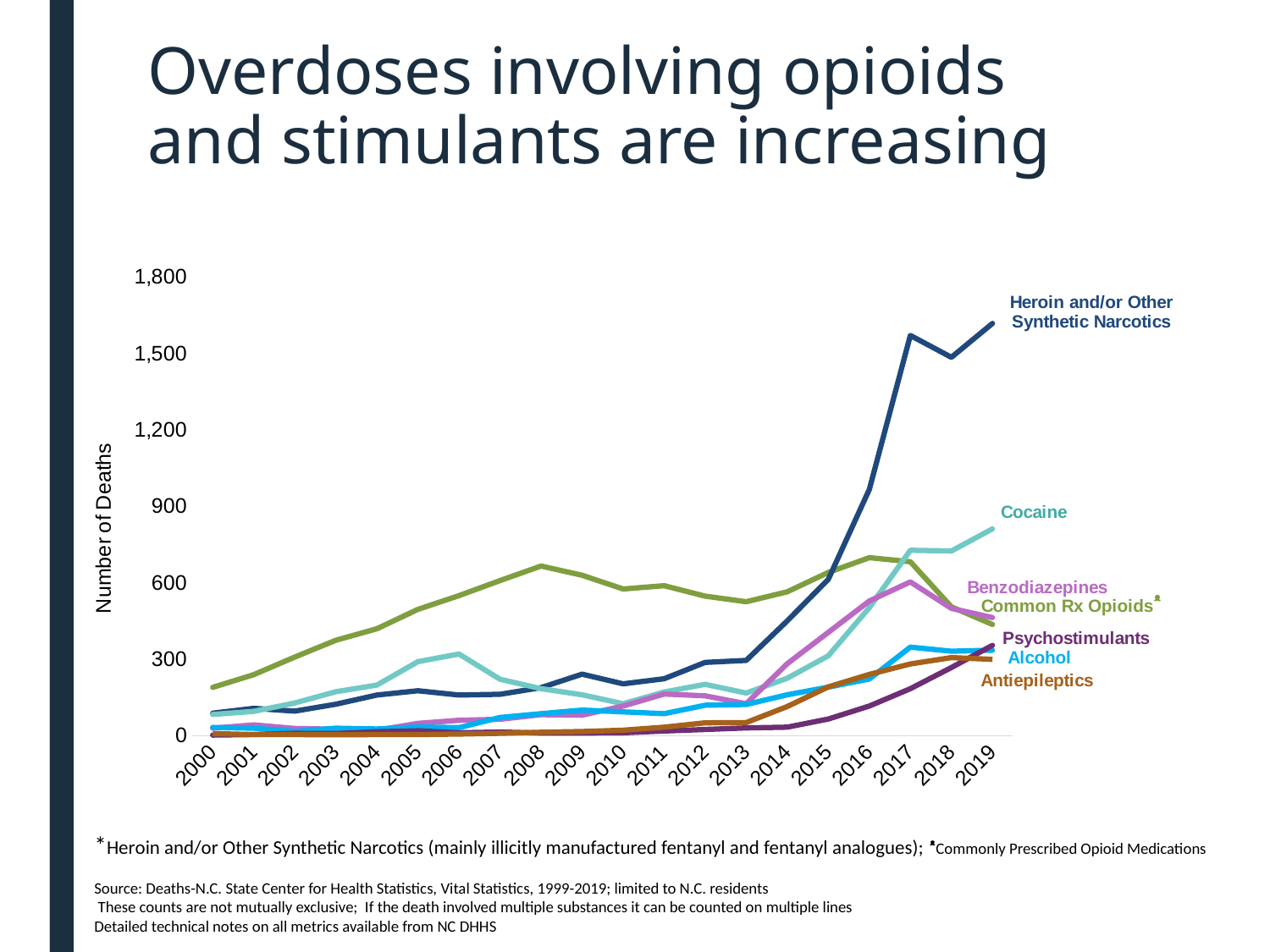
What kind of chart is shown on the slide? Line chart Is the number of deaths for Heroin and/or Other Synthetic Narcotics in 2019 greater or less than 1,500? greater Which series has the highest number of deaths in 2019? Heroin and/or Other Synthetic Narcotics In 2019, which series has more deaths: Cocaine or Common Rx Opioids? Cocaine Which series has the highest number of deaths in 2008? Common Rx Opioids Does the Common Rx Opioids line rise or fall from 2016 to 2019? Fall Is the number of deaths for Common Rx Opioids in 2008 greater or less than 600? greater How many years are shown along the x axis of the chart? 20 How many series (substance categories) are plotted on the chart? 7 Is the number of deaths for Cocaine in 2019 greater or less than 900? less What is the label on the y axis of the chart? Number of Deaths Does the Heroin and/or Other Synthetic Narcotics line rise or fall overall from 2000 to 2019? Rise